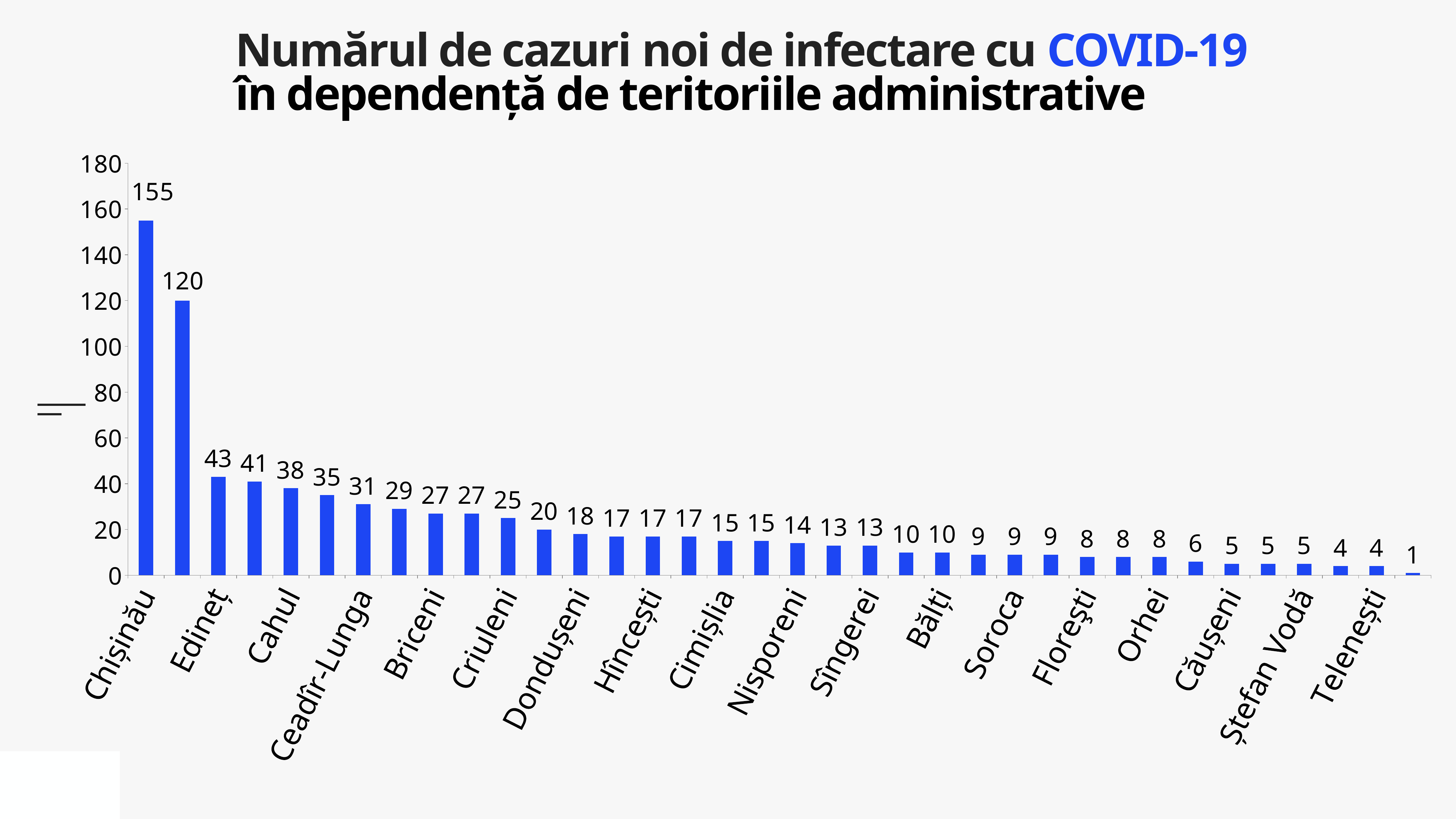
What kind of chart is shown? bar chart Is the value for Chișinău greater or less than 140? greater Which category has the highest value? Chișinău What is the value of the shortest bar? 1 Do the values rise or fall from left to right along the x axis? fall How many bars are plotted in the chart? 36 What is the value of the tallest bar? 155 What is the value for Chișinău? 155 What is the highest value shown on the vertical axis? 180 Which is larger, the value for Chișinău or the value for Edineț? Chișinău What is the difference between the two tallest bars (155 and 120)? 35